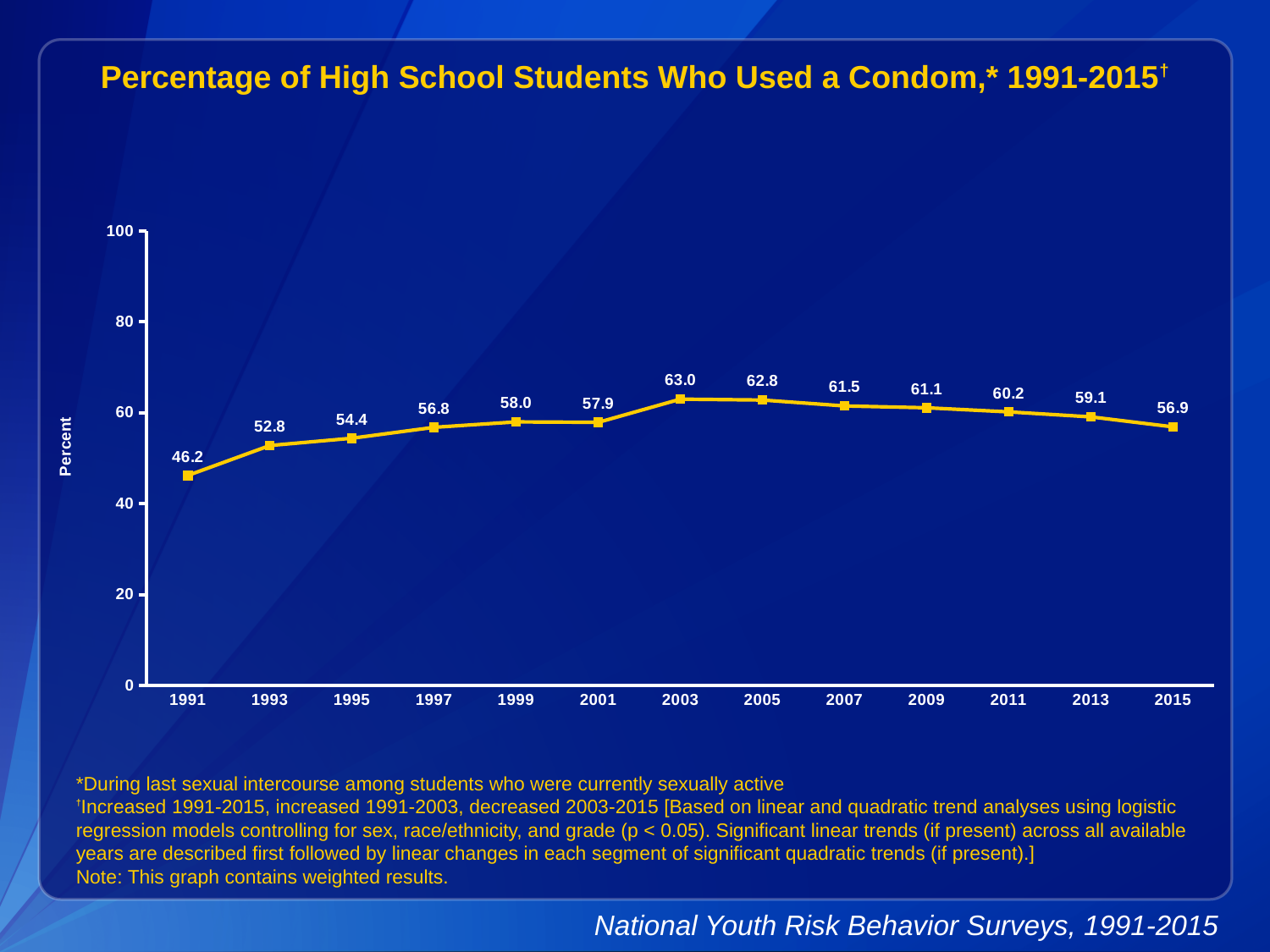
What value is shown for 2003? 63.0 What is the difference between the 2005 value and the 2015 value? 5.9 Which year has the larger value, 1997 or 2011? 2011 What kind of chart is shown on the slide? line chart Is the value for 1993 greater or less than 60? less Which year has the highest value on the chart? 2003 What was the percentage in 2015? 56.9 Do the values rise or fall from 2003 to 2015? fall Which year has the lowest value on the chart? 1991 What was the percentage of high school students who used a condom in 1991? 46.2 What is the difference between the 2003 value and the 1991 value? 16.8 How many years are plotted on the chart? 13